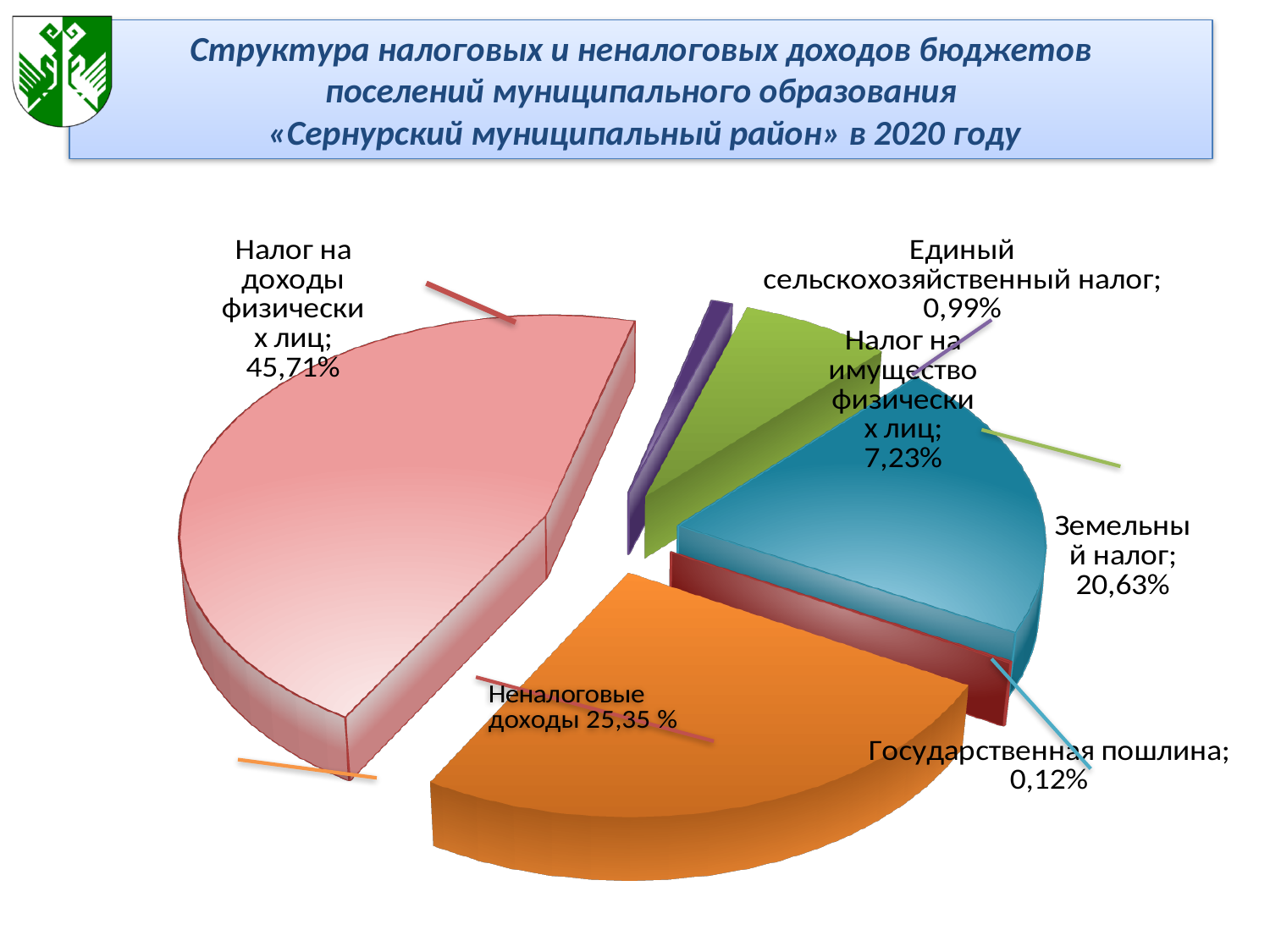
What is the value shown for «Государственная пошлина»? 0,12% What is the value shown for «Налог на имущество физических лиц»? 7,23% What is the value shown for «Единый сельскохозяйственный налог»? 0,99% What is the value shown for «Земельный налог»? 20,63% What is the value shown for «Неналоговые доходы»? 25,35 % Which category has the smallest share of the pie? Государственная пошлина Which is larger: «Земельный налог» or «Неналоговые доходы»? Неналоговые доходы What share of the pie does «Налог на доходы физических лиц» have? 45,71% What kind of chart is shown on the slide? Pie chart How many slices does the pie chart have? 6 What is the difference in percentage points between «Налог на доходы физических лиц» and «Земельный налог»? 25,08 Which category has the largest share of the pie? Налог на доходы физических лиц